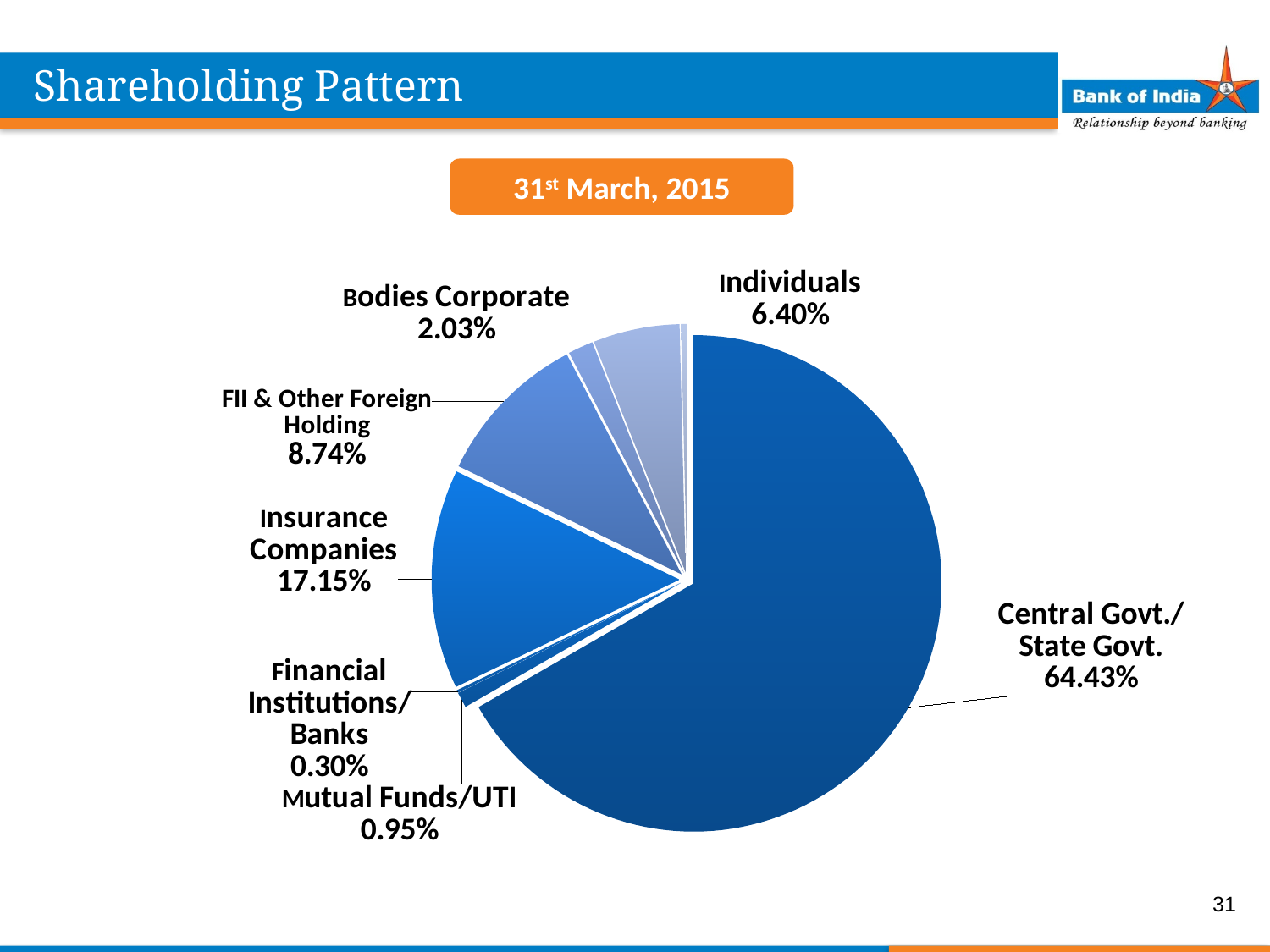
What is the difference between the shares of Insurance Companies and FII & Other Foreign Holding? 8.41% What share of shareholding is held by Mutual Funds/UTI? 0.95% Which category has the largest share of the pie? Central Govt./State Govt. How many categories are shown in the pie chart? 7 What kind of chart is shown on the slide? pie chart What share of shareholding is held by Insurance Companies? 17.15% What is the combined share of Individuals and Bodies Corporate? 8.43% What date does the chart's shareholding pattern refer to? 31st March, 2015 What share of shareholding is held by Central Govt./State Govt.? 64.43% Which category has the smallest share of the pie? Financial Institutions/Banks Which is larger, the share of Individuals or the share of Bodies Corporate? Individuals What share of shareholding is held by FII & Other Foreign Holding? 8.74%